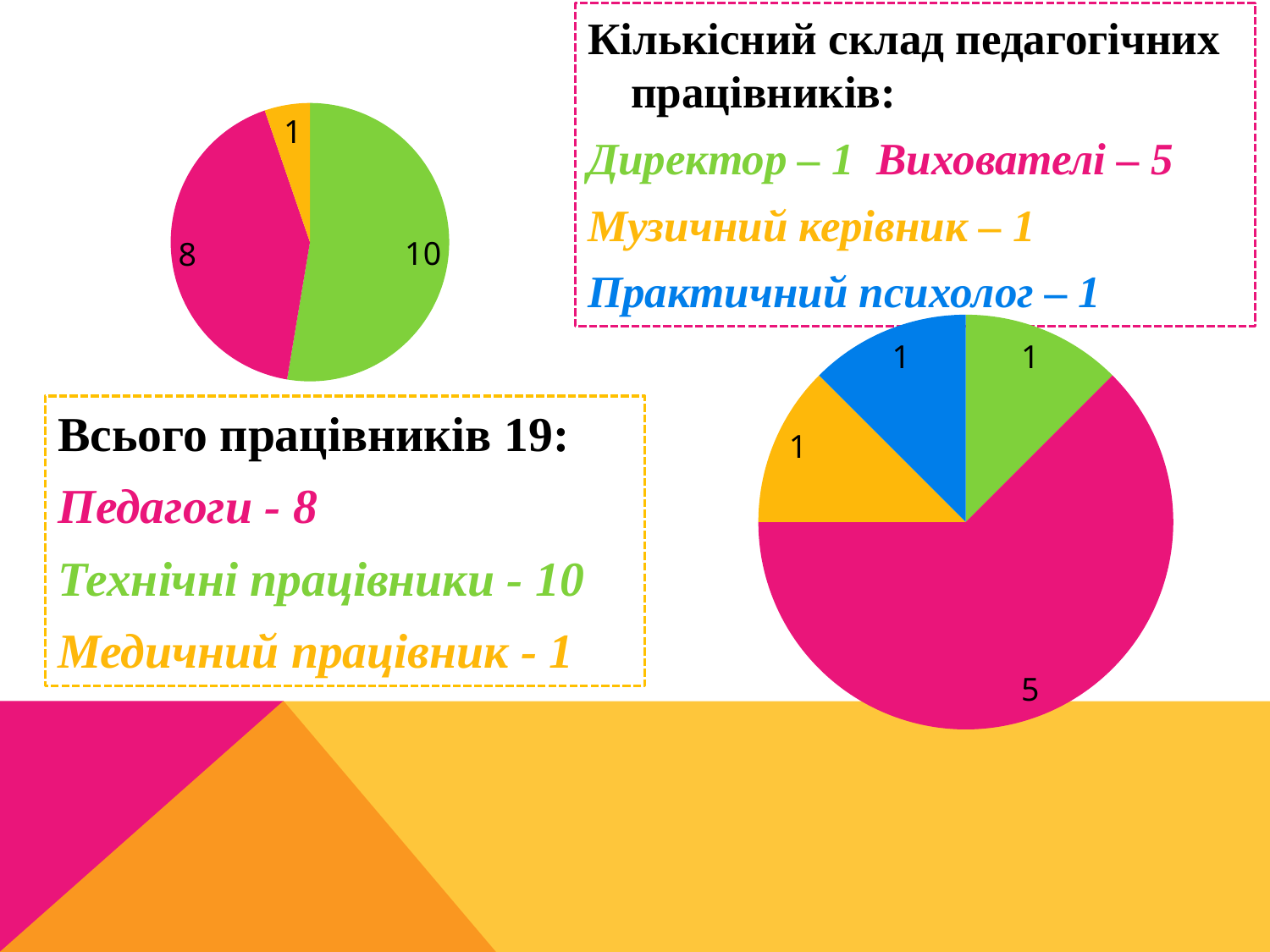
What kind of chart is shown on the right side of the slide? pie chart In the pie chart on the left, what is the difference between the green slice and the pink slice? 2 In the pie chart on the left, which slice has the largest value? the green slice (10) What kind of chart is shown on the left side of the slide? pie chart In the pie chart on the left, which slice has the smallest value? the yellow slice (1) In the pie chart on the left, what is the value of the green slice? 10 In the pie chart on the right, how many slices are there? 4 In the pie chart on the left, what is the value of the pink slice? 8 In the pie chart on the right, what is the value of the pink slice? 5 In the pie chart on the right, what share of the total does the pink slice (5) represent? 62.5% In the pie chart on the left, how many slices are there? 3 In the pie chart on the right, what is the total of all slices? 8